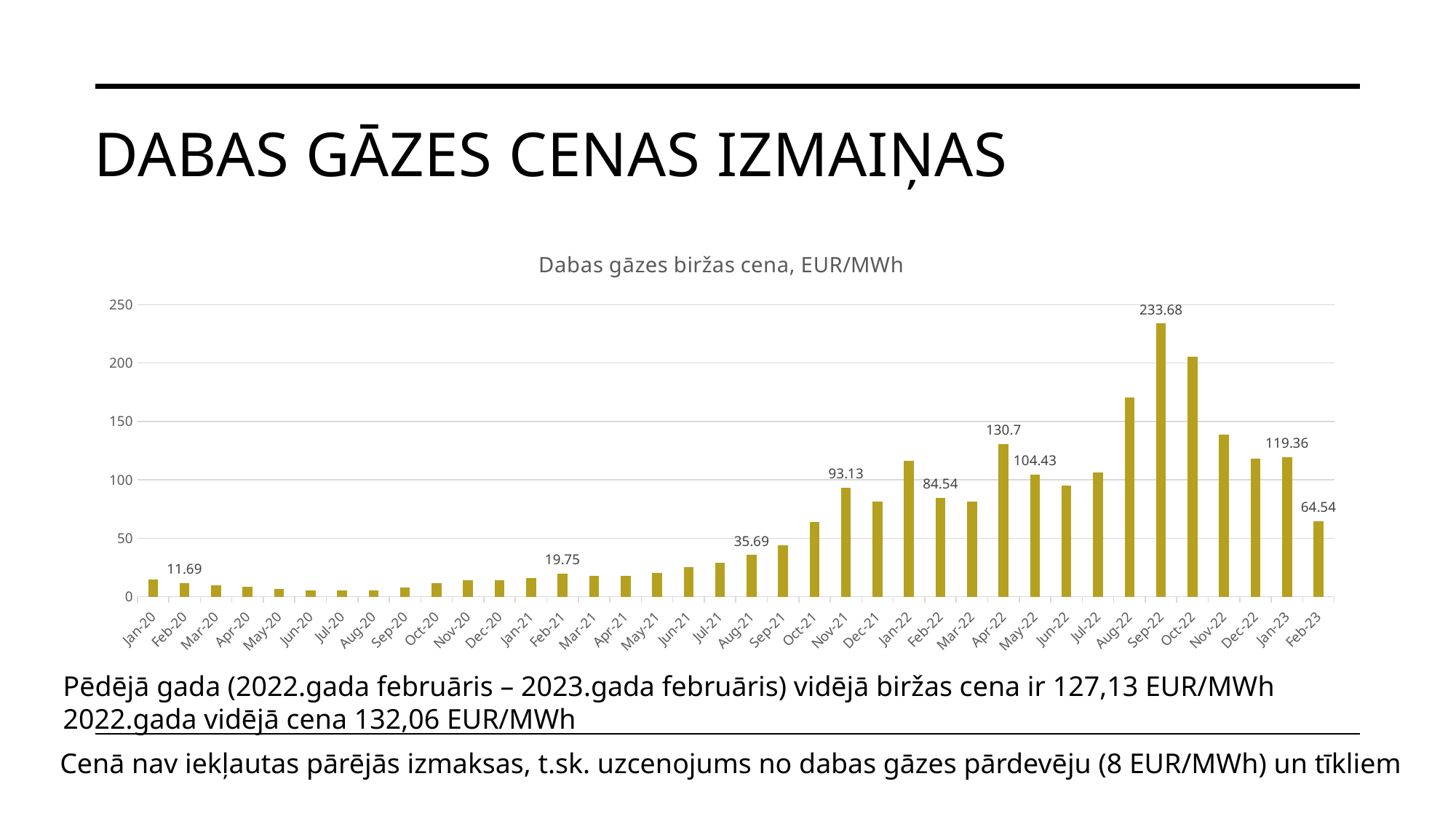
What is the difference between the values for Sep-22 and Apr-22? 102.98 Do the values rise or fall from Sep-22 to Feb-23? Fall What is the difference between the values for Jan-23 and Feb-23? 54.82 Is the value for Oct-22 greater or less than 200? greater What is the value for Apr-22? 130.7 Which month has the highest value? Sep-22 How many months (bars) are shown on the chart? 38 What is the value for Feb-23? 64.54 What type of chart is shown on the slide? Bar chart What is the title of the chart? Dabas gāzes biržas cena, EUR/MWh What is the value for Sep-22? 233.68 Which is larger, the value for Nov-21 or the value for Feb-22? Nov-21